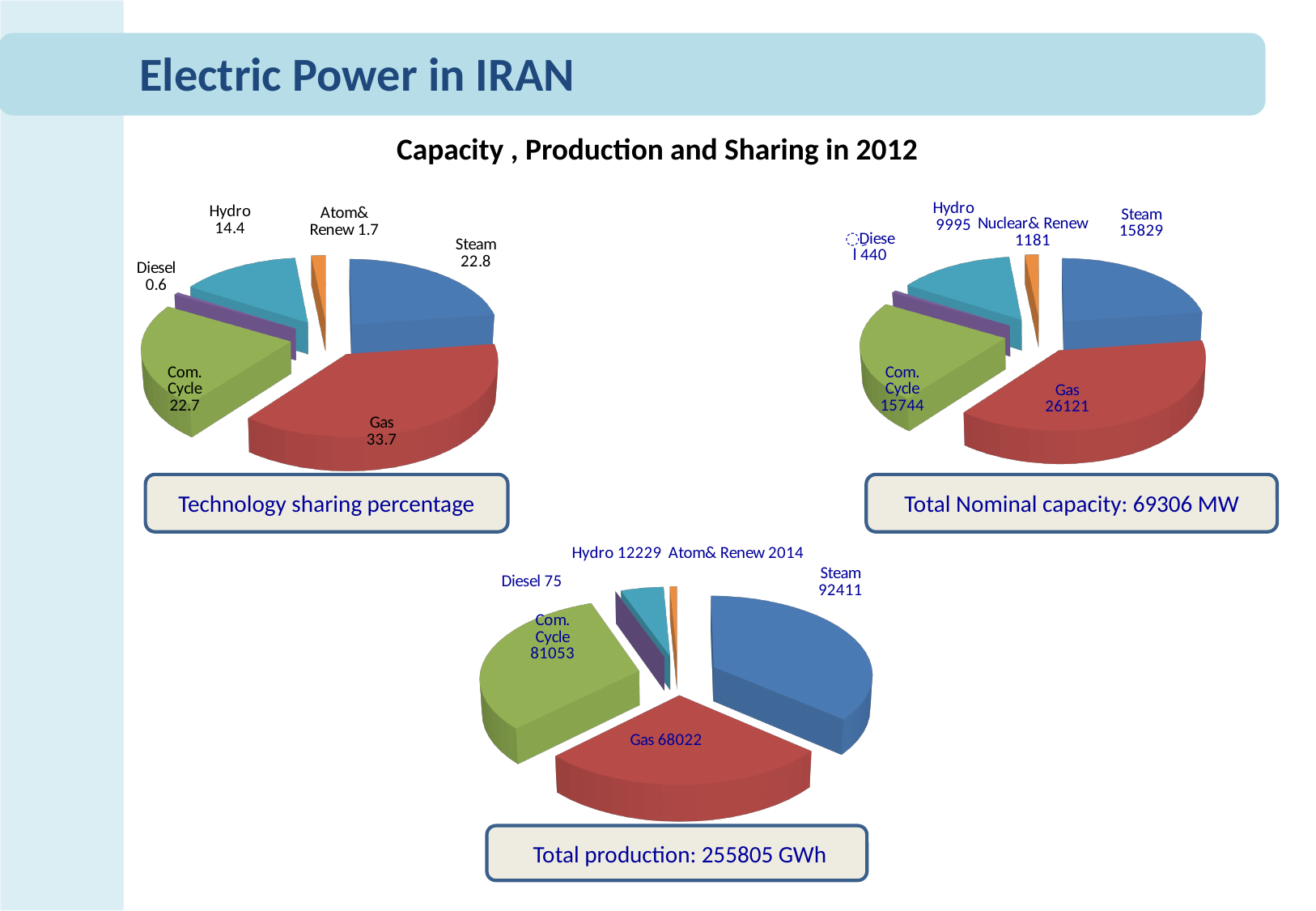
What type of chart is used for 'Technology sharing percentage'? Pie chart In the 'Total Nominal capacity' pie chart, what is the value for Com. Cycle? 15744 How many categories does the 'Total production' pie chart show? 6 In the 'Technology sharing percentage' pie chart, which category has the smallest share? Diesel In the 'Technology sharing percentage' pie chart, what is the value for Gas? 33.7 In the 'Total Nominal capacity' pie chart, which category has the largest value? Gas What total nominal capacity is stated below the top-right pie chart? 69306 MW In the 'Total production' pie chart, what is the value for Steam? 92411 In the 'Technology sharing percentage' pie chart, what is the difference between Steam and Hydro? 8.4 In the 'Total Nominal capacity' pie chart, what is the difference between Steam and Com. Cycle? 85 In the 'Total production' pie chart, what is the value for Diesel? 75 In the 'Total production' pie chart, which is larger, Com. Cycle or Gas? Com. Cycle